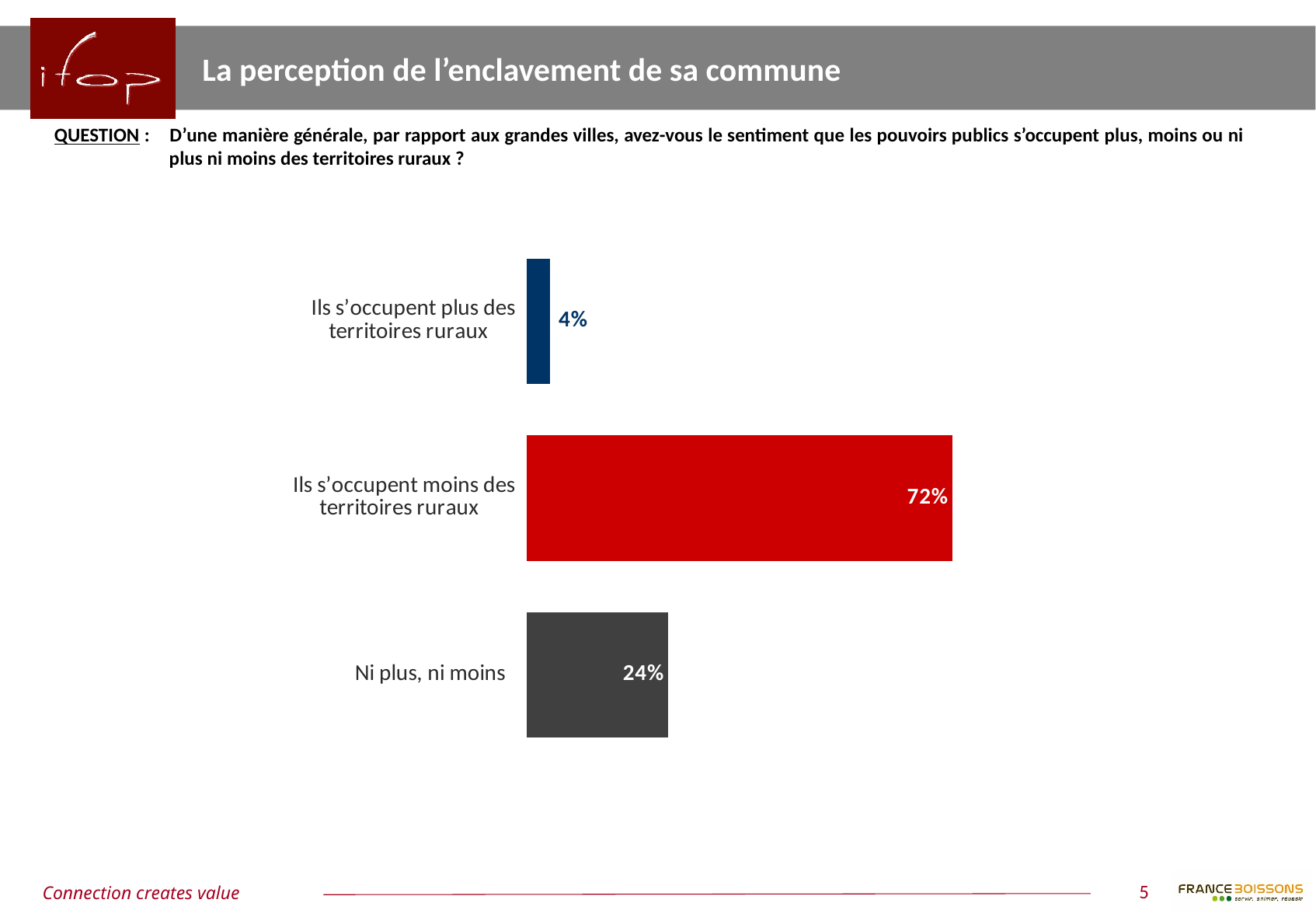
Which is larger: the value for "Ni plus, ni moins" or the value for "Ils s'occupent plus des territoires ruraux"? Ni plus, ni moins What is the difference in percentage points between "Ils s'occupent moins des territoires ruraux" and "Ni plus, ni moins"? 48 points What is the title of the slide? La perception de l'enclavement de sa commune What type of chart is shown on the slide? Bar chart Which response category has the lowest value? Ils s'occupent plus des territoires ruraux What percentage of respondents say the public authorities take care less of rural territories ("Ils s'occupent moins des territoires ruraux")? 72% Which response category has the highest value? Ils s'occupent moins des territoires ruraux What is the difference in percentage points between "Ni plus, ni moins" and "Ils s'occupent plus des territoires ruraux"? 20 points What percentage of respondents say the public authorities take care more of rural territories ("Ils s'occupent plus des territoires ruraux")? 4% What is the value shown for "Ni plus, ni moins"? 24% How many response categories are shown in the chart? 3 What colour is the bar for "Ils s'occupent moins des territoires ruraux"? Red